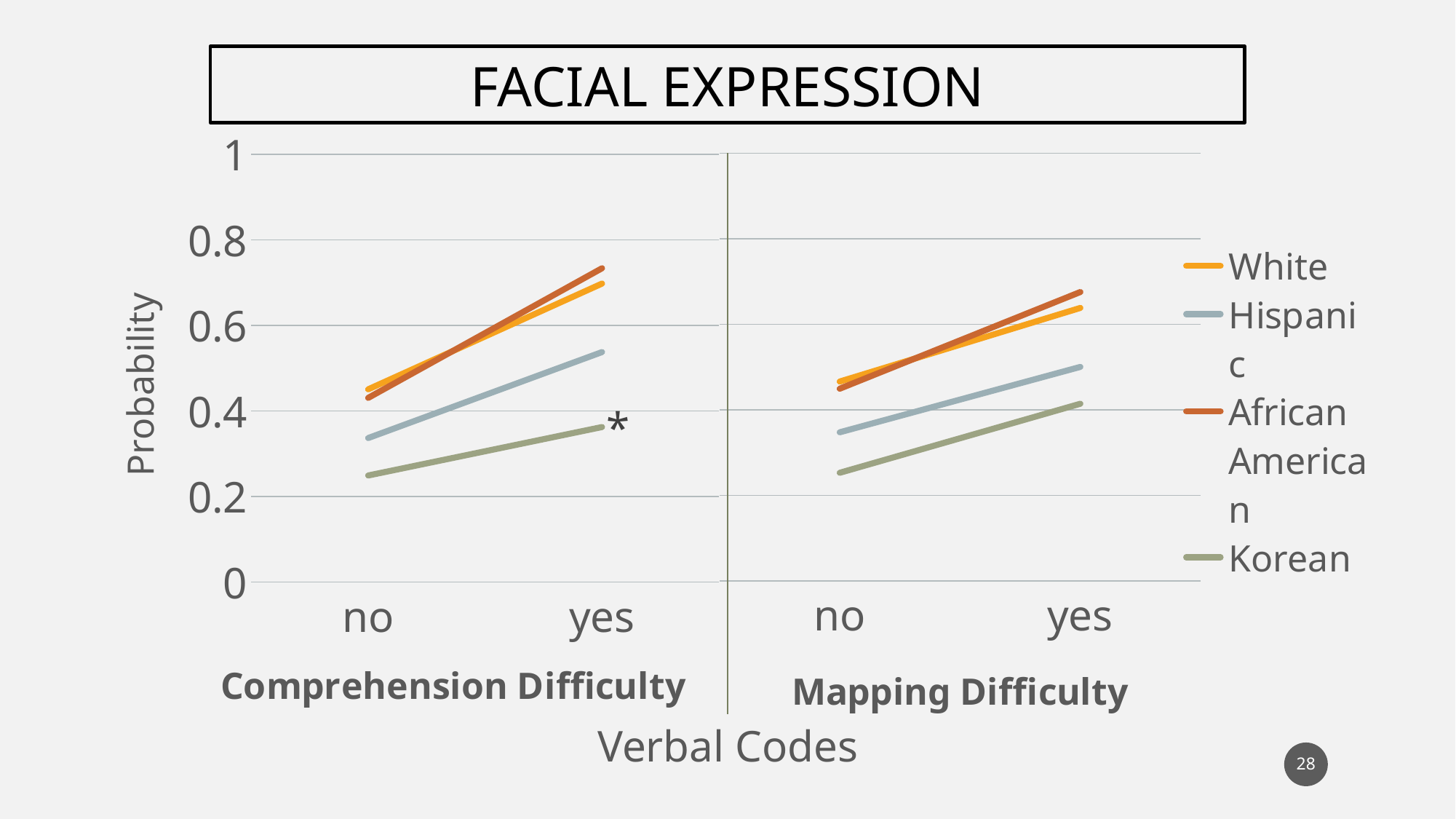
How many series does the legend list? 4 Is the probability for White at 'yes' under Mapping Difficulty greater or less than 0.6? greater Which is larger at 'yes' under Comprehension Difficulty: the probability for Hispanic or for Korean? Hispanic What is the label of the vertical axis? Probability Is the probability for Hispanic at 'no' under Mapping Difficulty greater or less than 0.4? less Does the probability for Hispanic rise or fall from 'no' to 'yes' under Comprehension Difficulty? rise What kind of chart is shown on the slide? line chart Is the probability for African American at 'yes' under Comprehension Difficulty greater or less than 0.8? less Which series has the lowest probability at 'yes' under Comprehension Difficulty? Korean What is the title of the chart? FACIAL EXPRESSION Which series has the lowest probability at 'no' under Mapping Difficulty? Korean